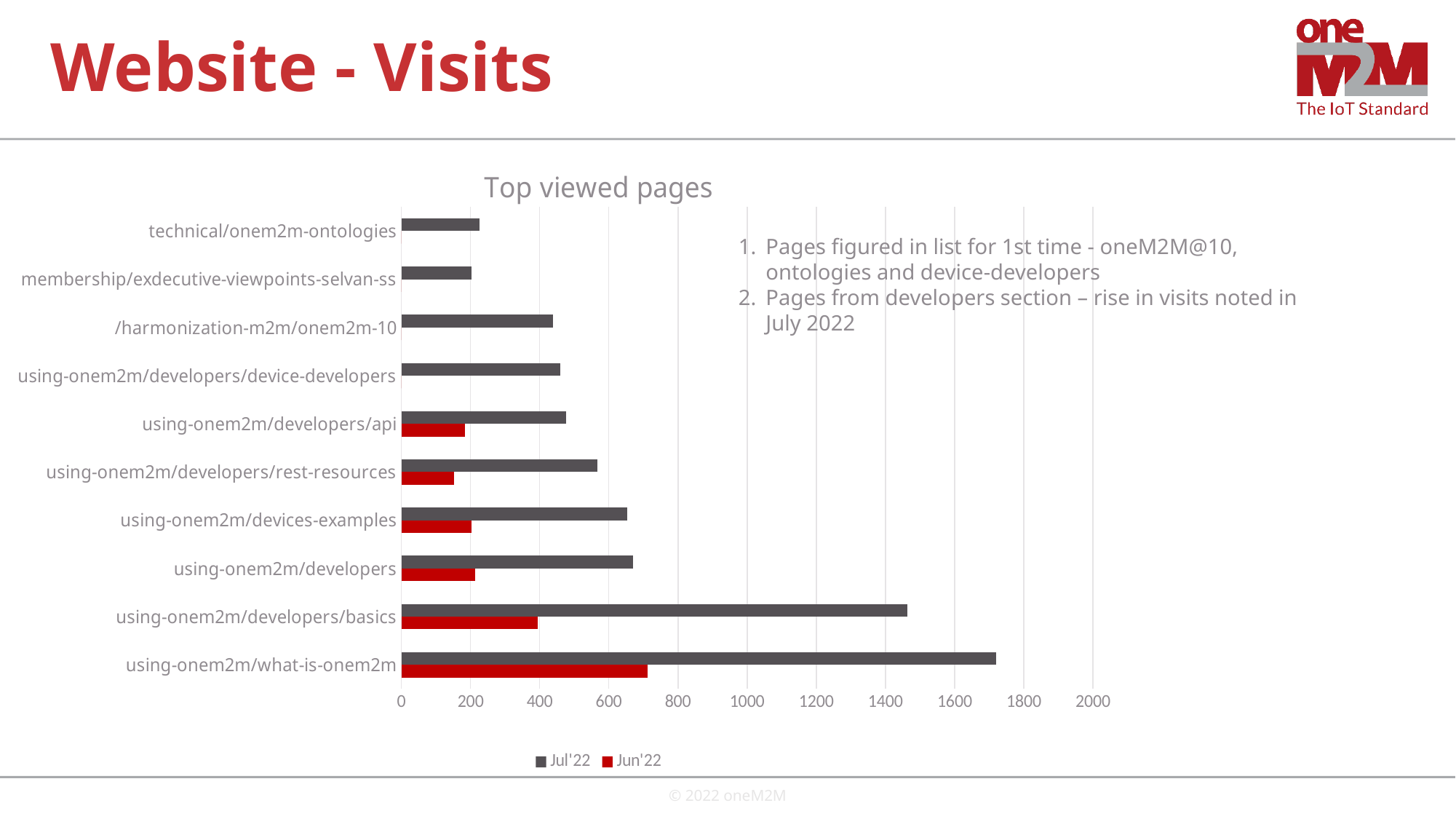
What is the title of the chart? Top viewed pages What kind of chart is shown on the slide? bar chart How many pages (categories) are plotted in the chart? 10 Which page has the highest Jun'22 value? using-onem2m/what-is-onem2m Is the Jul'22 value for using-onem2m/developers/rest-resources greater or less than 600? less Is the Jun'22 value for using-onem2m/what-is-onem2m greater or less than 600? greater How many series does the chart's legend list? 2 Which page has the highest Jul'22 value? using-onem2m/what-is-onem2m Is the Jul'22 value for using-onem2m/developers/basics greater or less than 1400? greater Which is larger: the Jul'22 value for using-onem2m/developers/basics or the Jul'22 value for using-onem2m/developers? using-onem2m/developers/basics Which series is shown in red in the chart? Jun'22